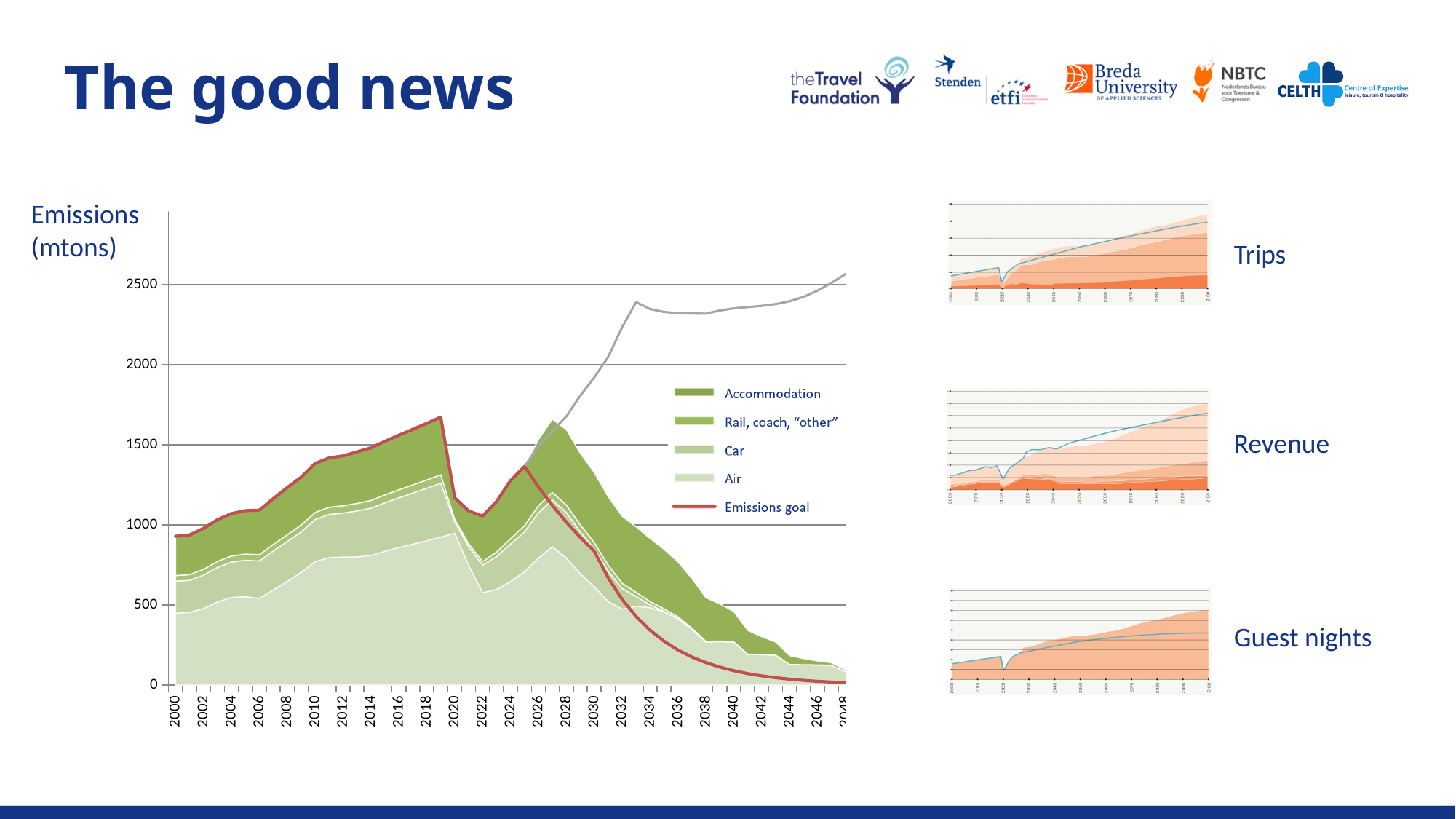
On the emissions chart, is the total emissions value in 2000 greater or less than 1000? less On the emissions chart, is the total emissions value in 2018 greater or less than 1500? greater On the emissions chart, does the grey line rise or fall between 2026 and 2034? rise On the emissions chart, is the Emissions goal value in 2040 greater or less than 500? less On the emissions chart, which series is shown as a red line rather than a shaded area? Emissions goal What is the label of the vertical axis on the emissions chart? Emissions (mtons) What kind of chart is the large chart on the left of the slide? Stacked area chart How many entries does the legend of the emissions chart list? 5 On the emissions chart, does the Emissions goal line rise or fall between 2026 and 2048? fall How many small charts are shown on the right side of the slide, and what are they labelled? 3: Trips, Revenue, Guest nights